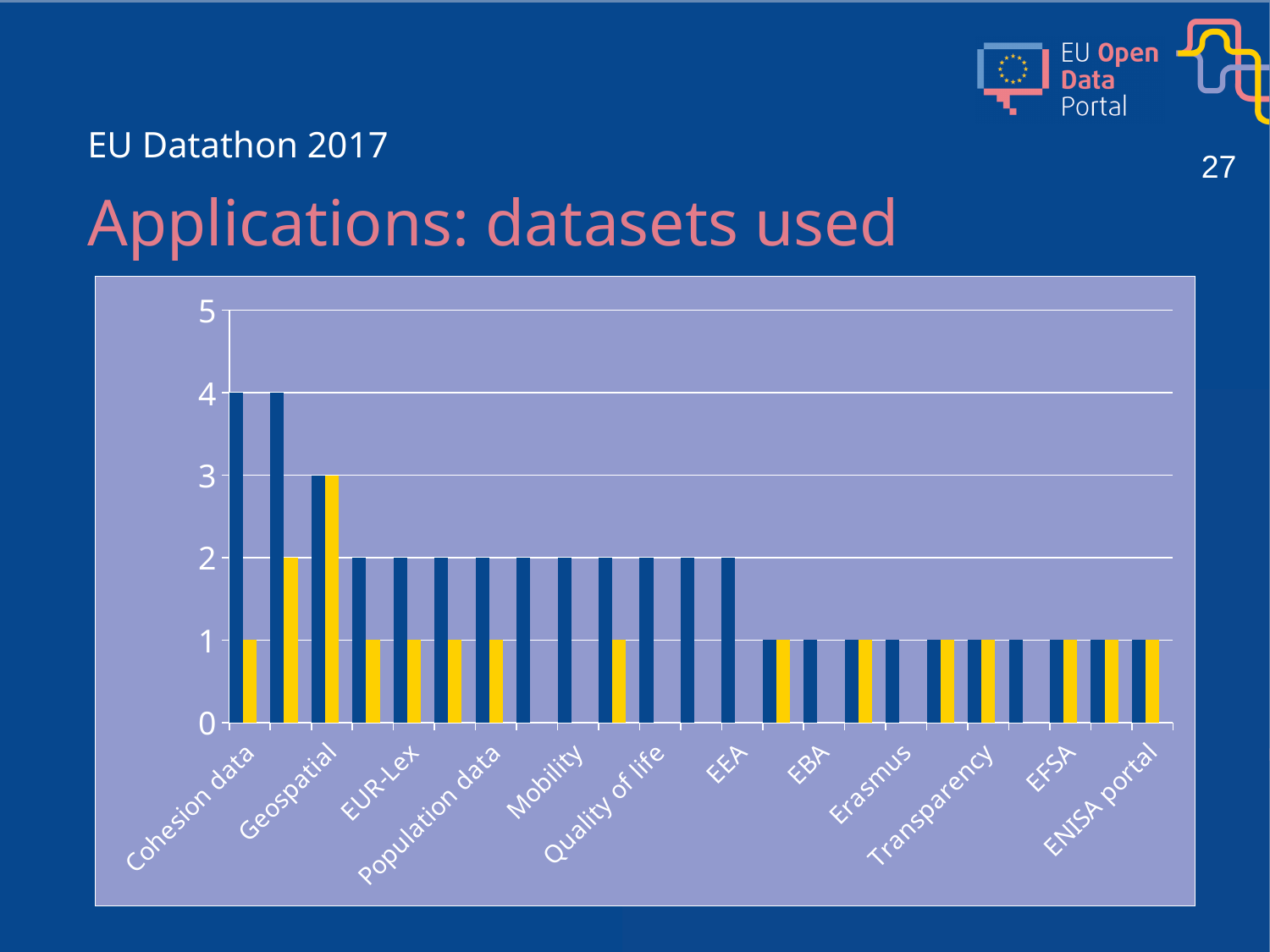
How many category labels are printed on the x axis? 12 Do the blue bar values generally rise or fall from left to right along the x axis? fall What kind of chart is shown on the slide? bar chart What is the value of the blue bar for Cohesion data? 4 What is the value of the yellow bar for Geospatial? 3 What is the value of the blue bar for Transparency? 1 What is the difference between the blue bar for Cohesion data and the blue bar for EUR-Lex? 2 What is the value of the blue bar for EUR-Lex? 2 What is the title of the slide containing the chart? Applications: datasets used Is the blue bar for Cohesion data greater or less than 3? greater Which has the larger blue bar, Cohesion data or Geospatial? Cohesion data What is the value of the yellow bar for Cohesion data? 1